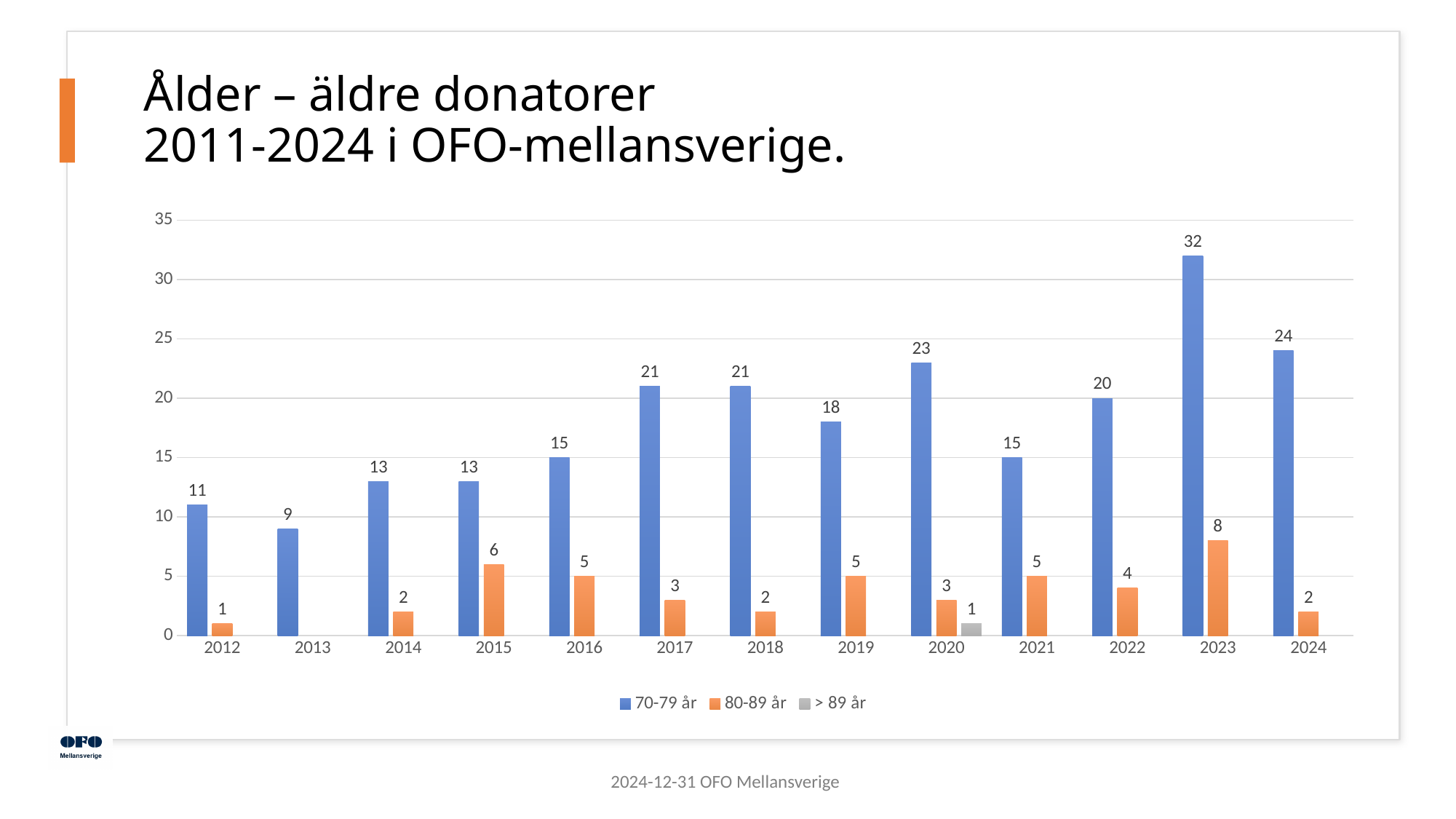
How many series does the legend list? 3 What is the difference between the 70-79 år value in 2023 and in 2024? 8 Which year has the lowest value for 70-79 år? 2013 What is the value for > 89 år in 2020? 1 What kind of chart is shown on the slide? Bar chart Which colour represents the 80-89 år series in the legend? Orange What is the total of the 70-79 år and 80-89 år values in 2023? 40 What is the value for 80-89 år in 2015? 6 How many years are shown on the x axis? 13 Which year has the highest value for 70-79 år? 2023 What is the value for 70-79 år in 2023? 32 Which is larger, the 80-89 år value in 2016 or in 2022? 2016